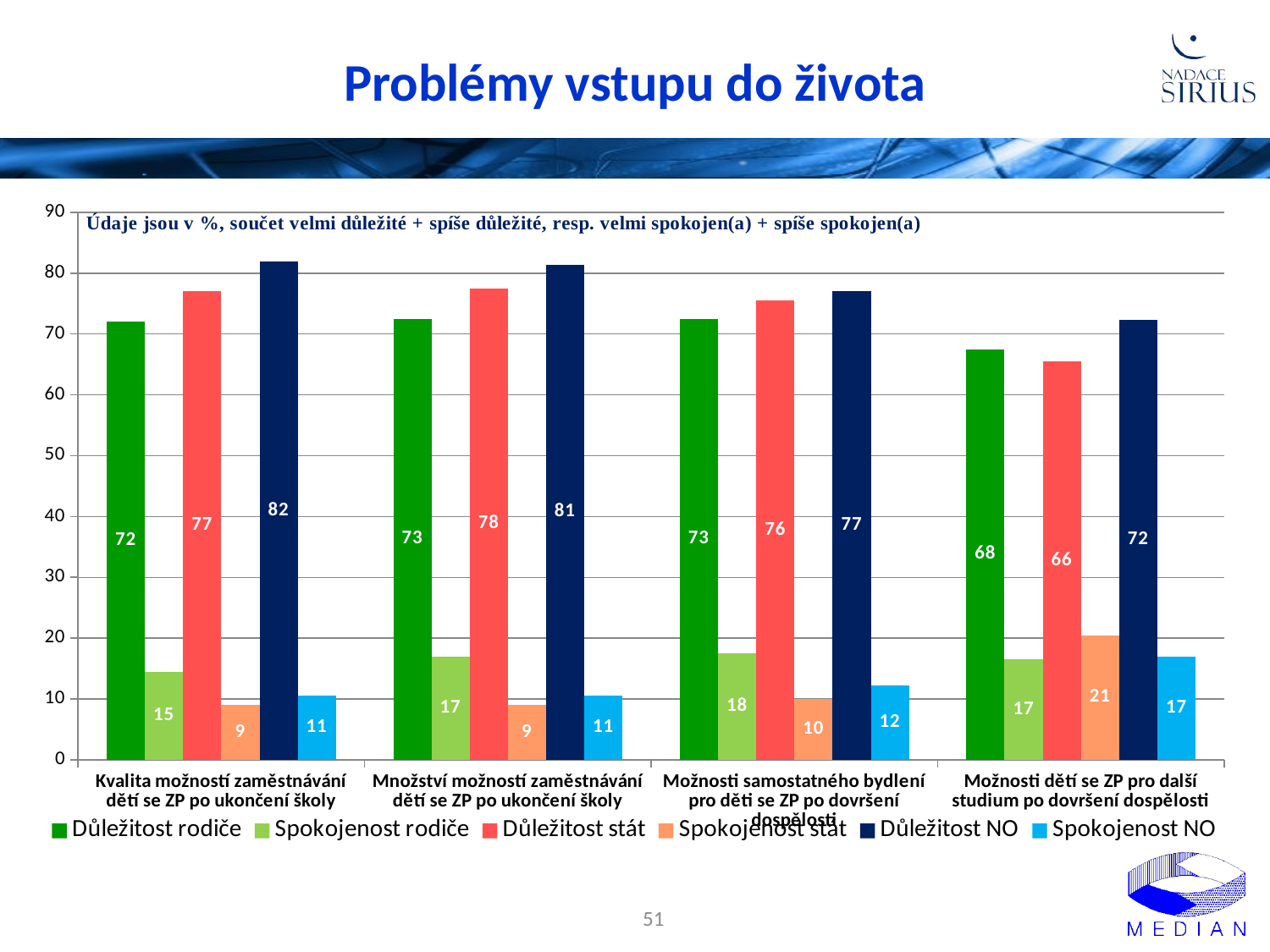
What is the value for Důležitost NO in the category "Kvalita možností zaměstnávání dětí se ZP po ukončení školy"? 82 What is the difference between Důležitost NO and Spokojenost NO in the category "Kvalita možností zaměstnávání dětí se ZP po ukončení školy"? 71 Which category has the highest value for Spokojenost rodiče? Možnosti samostatného bydlení pro děti se ZP po dovršení dospělosti What kind of chart is shown on the slide? bar chart Is the value for Důležitost stát in the category "Možnosti samostatného bydlení pro děti se ZP po dovršení dospělosti" greater or less than 70? greater How many categories are shown on the x axis of the chart? 4 What is the value for Důležitost stát in the category "Množství možností zaměstnávání dětí se ZP po ukončení školy"? 78 What is the value for Spokojenost stát in the category "Možnosti dětí se ZP pro další studium po dovršení dospělosti"? 21 In the category "Možnosti dětí se ZP pro další studium po dovršení dospělosti", which is larger: Důležitost rodiče or Důležitost stát? Důležitost rodiče How many series does the legend list? 6 Which category has the lowest value for Důležitost NO? Možnosti dětí se ZP pro další studium po dovršení dospělosti What colour are the bars for the series Důležitost rodiče? green